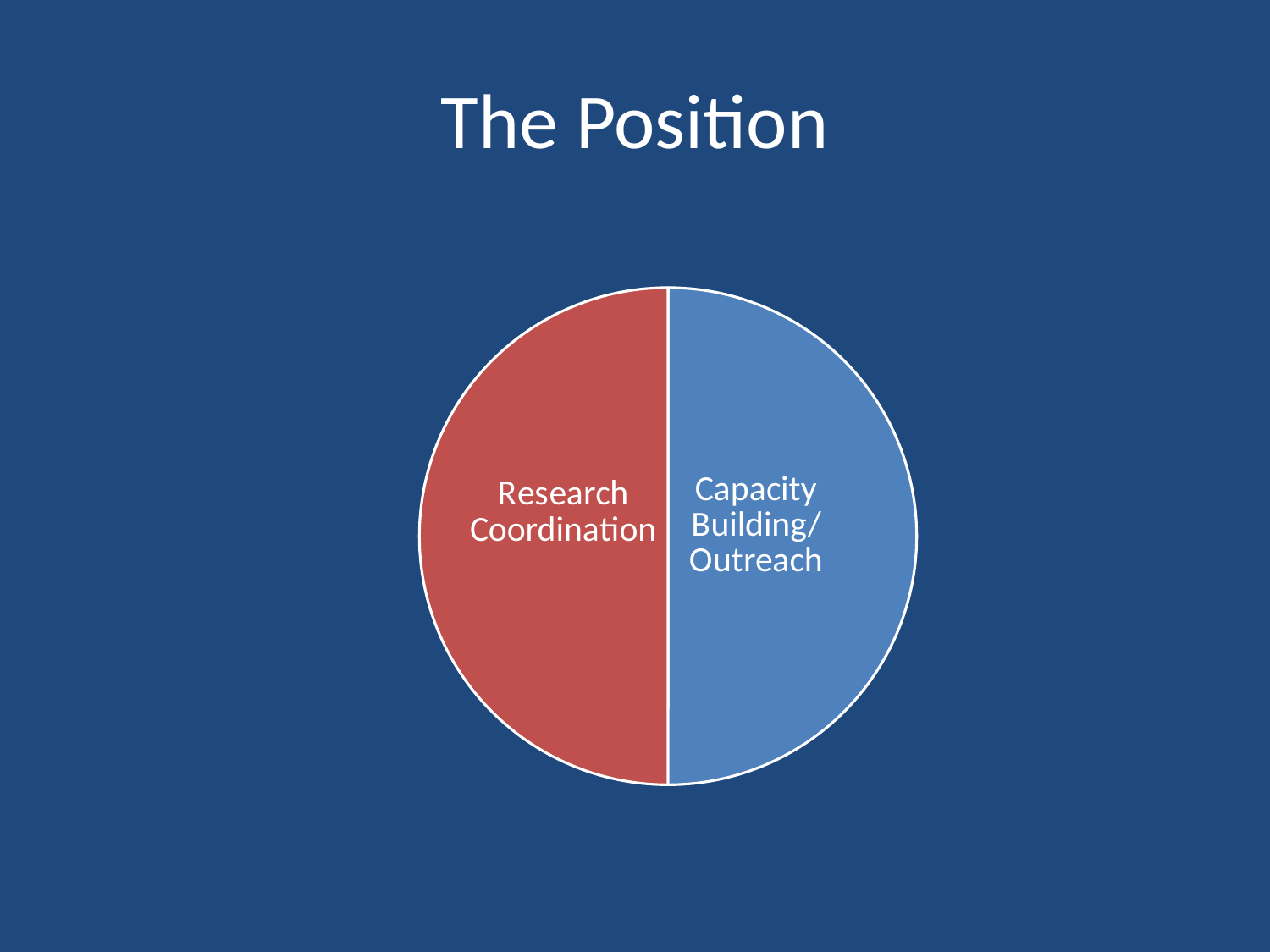
Which slice of the pie chart is on the left side? Research Coordination What is the title of the slide containing the pie chart? The Position How many slices does the pie chart have? 2 What is the label of the blue slice of the pie chart? Capacity Building/Outreach Which slice of the pie chart is coloured red? Research Coordination What kind of chart is shown on the slide? pie chart